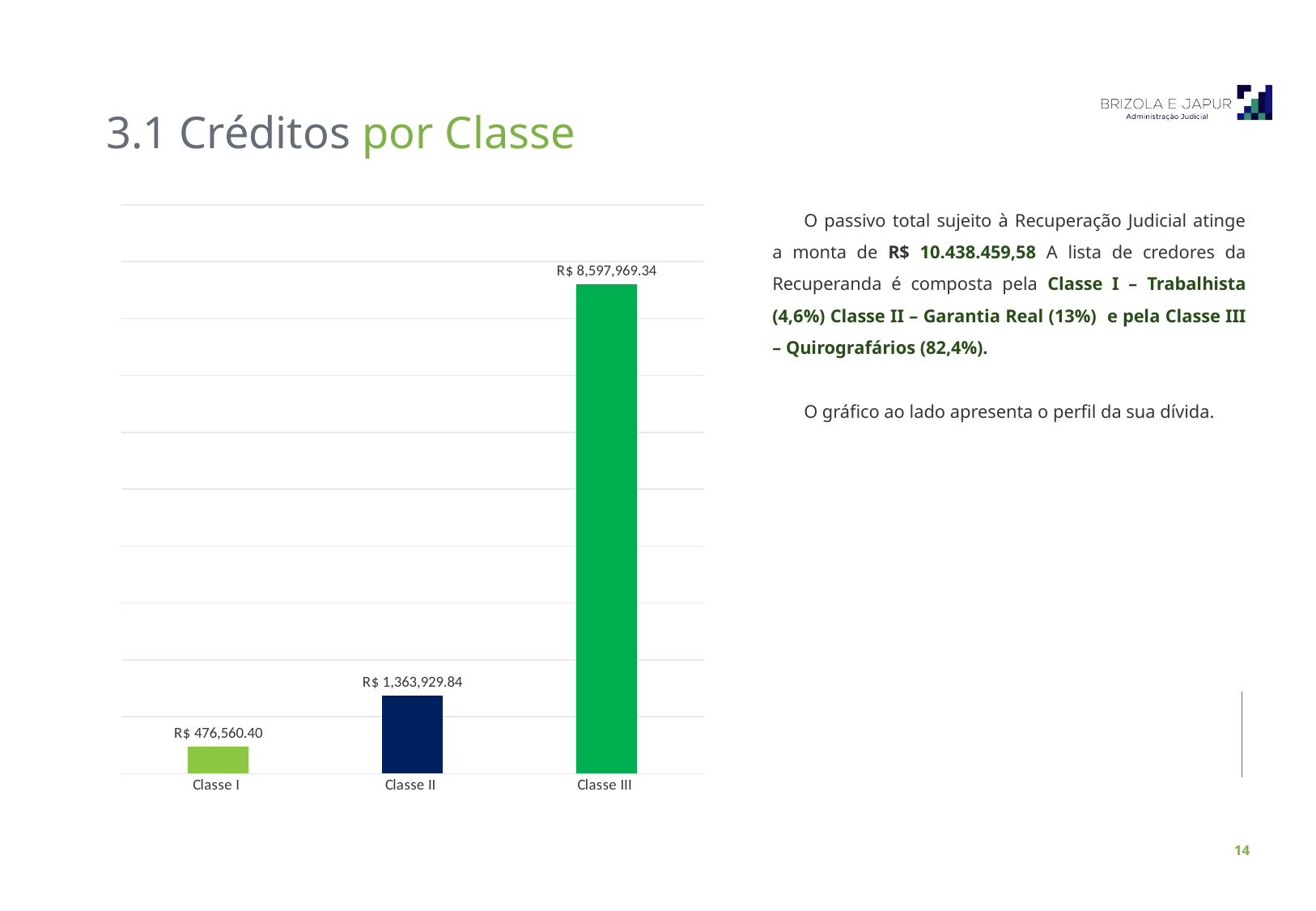
Which class has the highest value in the chart? Classe III Do the values rise or fall from Classe I to Classe III? Rise What is the value shown for Classe II? R$ 1,363,929.84 What kind of chart is shown on the slide? Bar chart What is the value shown for Classe I? R$ 476,560.40 Which is larger, the value for Classe I or the value for Classe II? Classe II What is the difference between the values for Classe III and Classe II? R$ 7,234,039.50 What colour is the bar for Classe II? Dark navy blue What is the value shown for Classe III? R$ 8,597,969.34 How many classes are plotted in the chart? 3 What is the difference between the values for Classe II and Classe I? R$ 887,369.44 Which class has the lowest value in the chart? Classe I